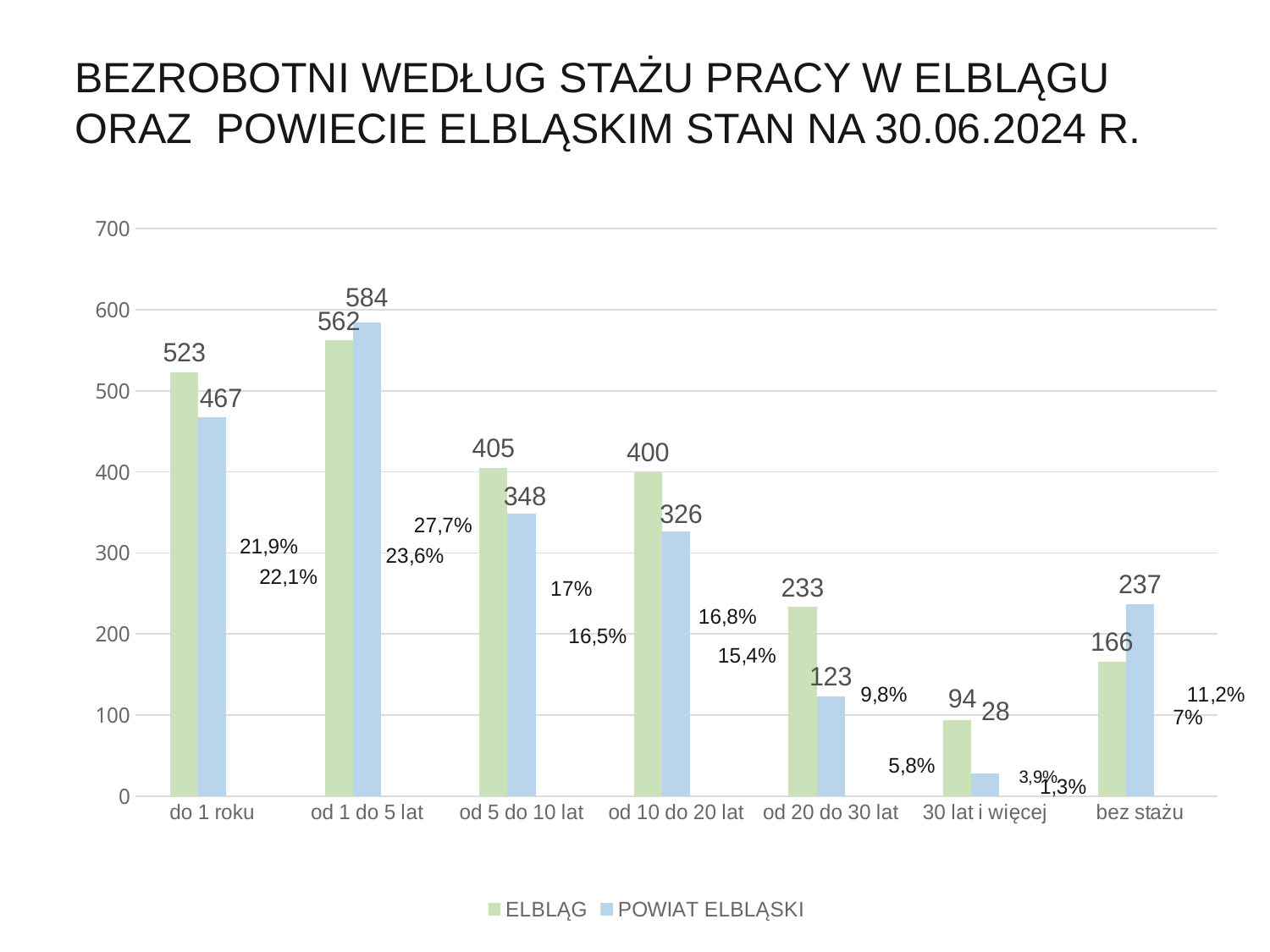
In the category "od 20 do 30 lat", which series has the larger value, ELBLĄG or POWIAT ELBLĄSKI? ELBLĄG How many series does the legend list? 2 Which category has the highest value for POWIAT ELBLĄSKI? od 1 do 5 lat What is the difference between the ELBLĄG and POWIAT ELBLĄSKI values in the category "do 1 roku"? 56 Which category has the lowest value for ELBLĄG? 30 lat i więcej What kind of chart is shown on the slide? bar chart Is the value for ELBLĄG in the category "od 5 do 10 lat" greater or less than 300? greater Which series is shown in blue? POWIAT ELBLĄSKI How many categories are shown on the x axis? 7 What is the value for ELBLĄG in the category "od 1 do 5 lat"? 562 What is the value for POWIAT ELBLĄSKI in the category "bez stażu"? 237 What is the value for POWIAT ELBLĄSKI in the category "30 lat i więcej"? 28